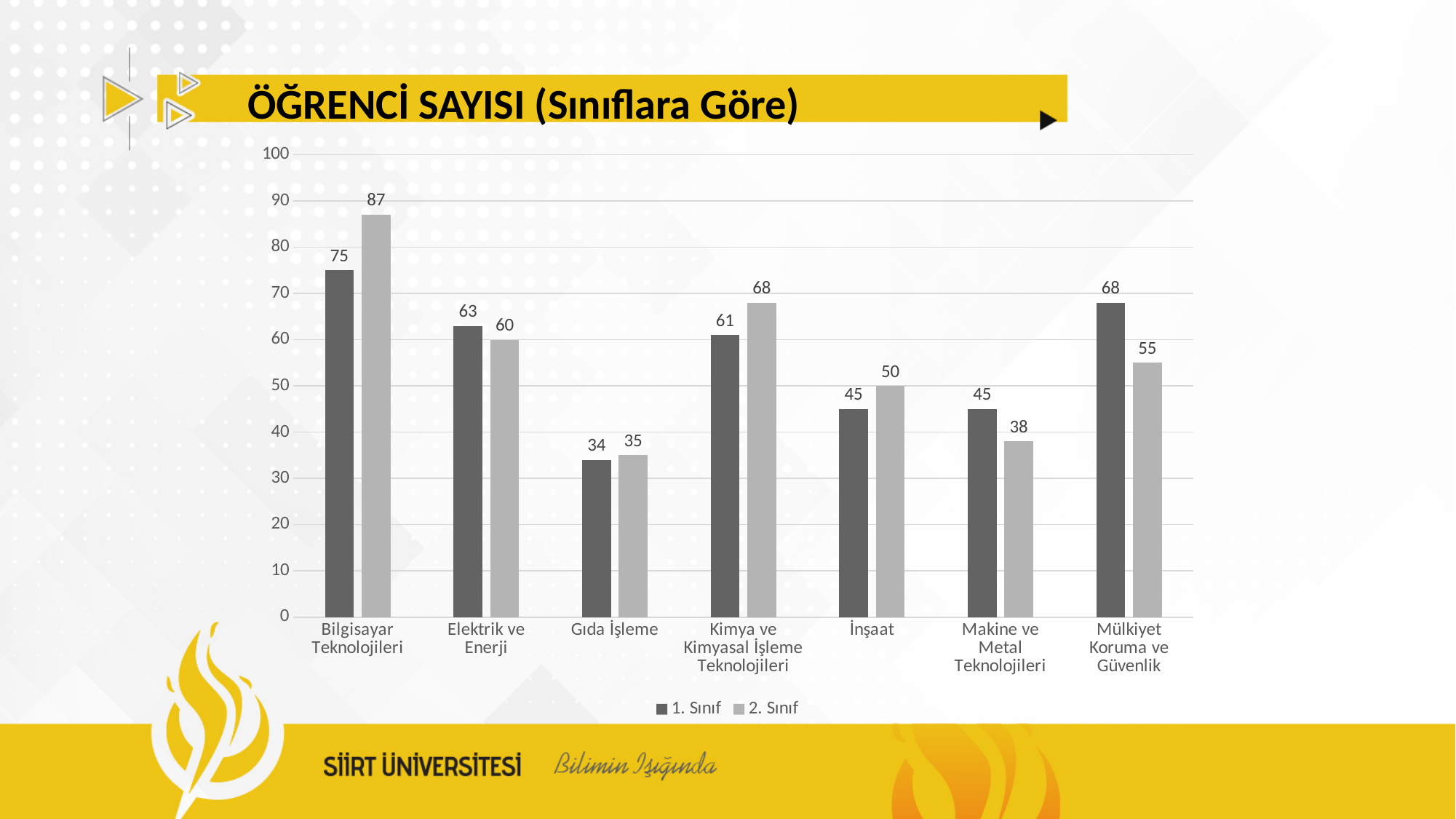
Is the 1. Sınıf value for Kimya ve Kimyasal İşleme Teknolojileri greater or less than 50? greater How many categories are shown on the x axis? 7 How many series does the legend list? 2 What is the title of the chart? ÖĞRENCİ SAYISI (Sınıflara Göre) Which category has the highest 2. Sınıf value? Bilgisayar Teknolojileri Which category has the lowest 1. Sınıf value? Gıda İşleme What kind of chart is shown on the slide? Bar chart What is the value for 1. Sınıf in Bilgisayar Teknolojileri? 75 What is the difference between the 2. Sınıf and 1. Sınıf values for Bilgisayar Teknolojileri? 12 What is the value for 2. Sınıf in Makine ve Metal Teknolojileri? 38 Which is larger for Elektrik ve Enerji, 1. Sınıf or 2. Sınıf? 1. Sınıf What is the value for 2. Sınıf in Mülkiyet Koruma ve Güvenlik? 55